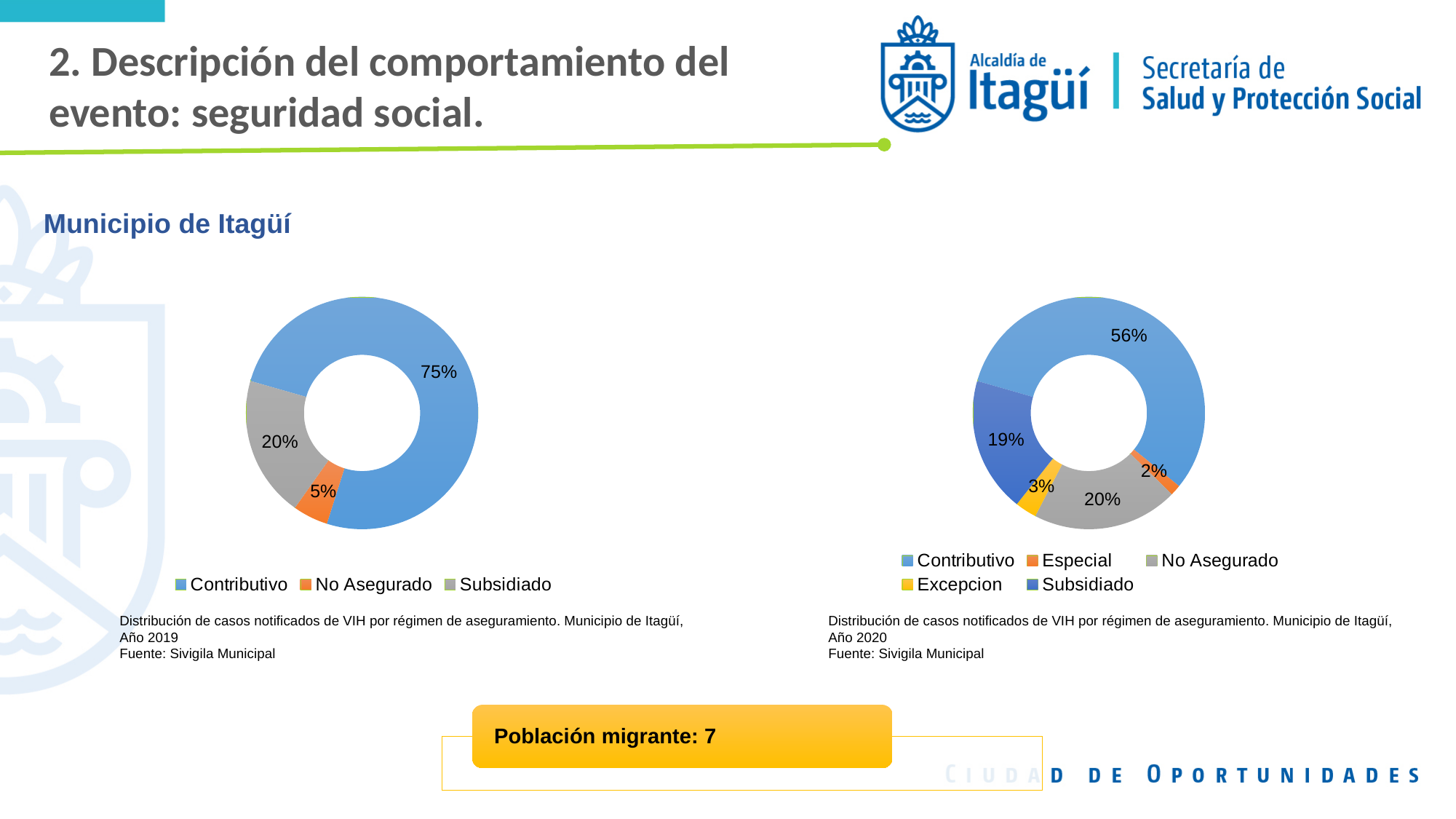
In the right chart (Año 2020), which is larger, No Asegurado or Subsidiado? No Asegurado How many categories does the legend of the right chart (Año 2020) list? 5 In the right chart (Año 2020), what share of cases is Especial? 2% In the left chart (Año 2019), what share of cases is No Asegurado? 5% In the right chart (Año 2020), which regime has the smallest share? Especial What type of chart is the left chart (Año 2019)? Doughnut chart In the right chart (Año 2020), what share of cases is Contributivo? 56% In the right chart (Año 2020), which regime has the largest share? Contributivo In the left chart (Año 2019), what share of cases is Contributivo? 75% In the left chart (Año 2019), what share of cases is Subsidiado? 20% In the left chart (Año 2019), what is the difference in percentage points between Contributivo and Subsidiado? 55 In the right chart (Año 2020), what share of cases is Excepcion? 3%